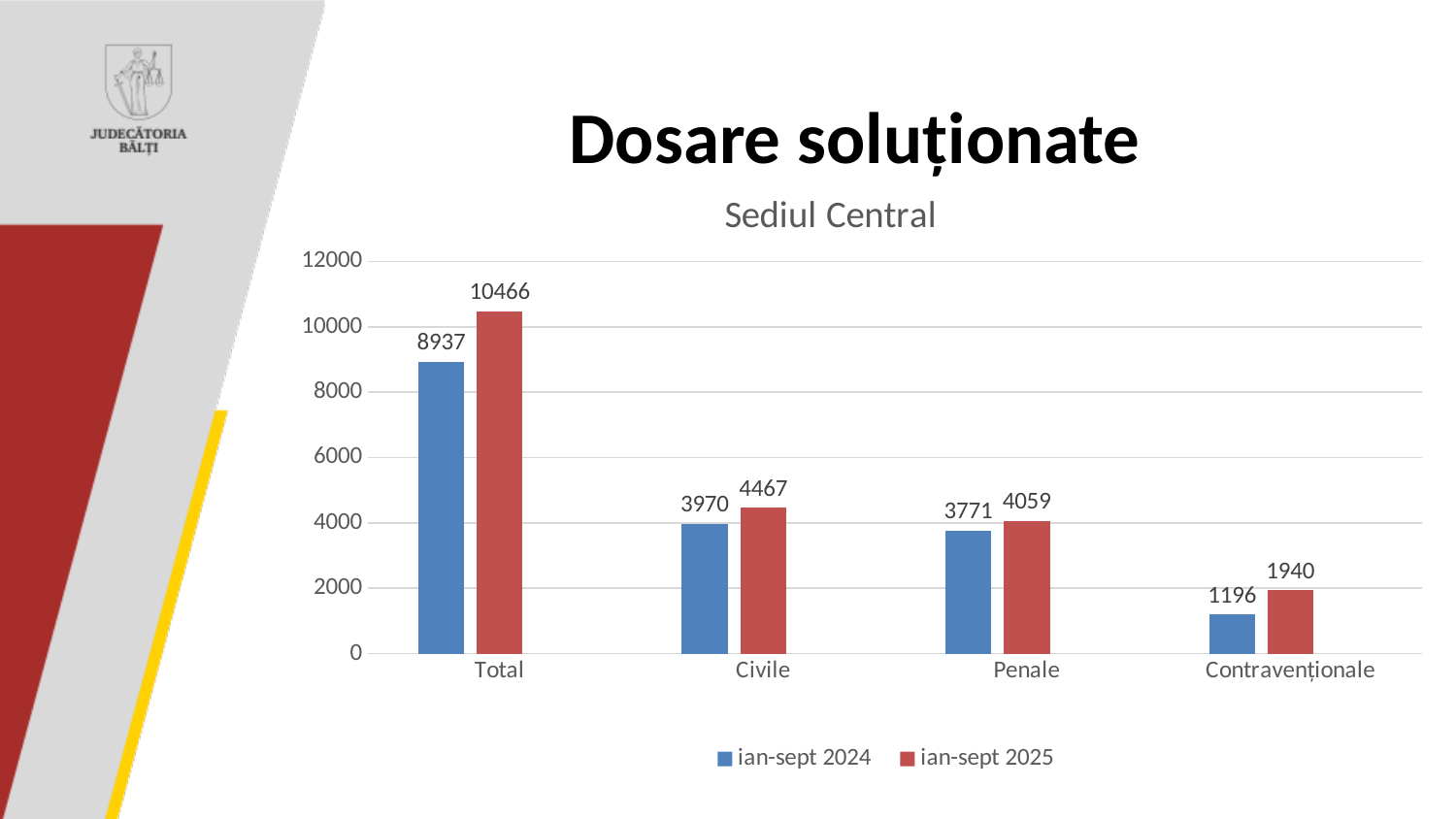
What is the value for Civile in the ian-sept 2024 series? 3970 How many series does the legend list? 2 Which category has the highest value in the ian-sept 2025 series? Total What kind of chart is shown on the slide? bar chart What is the difference between the ian-sept 2025 and ian-sept 2024 values for Penale? 288 What is the difference between the ian-sept 2025 and ian-sept 2024 values for Total? 1529 What is the value for Contravenționale in the ian-sept 2025 series? 1940 What is the value for Total in the ian-sept 2025 series? 10466 Which is larger for Civile: the ian-sept 2024 value or the ian-sept 2025 value? ian-sept 2025 Which category has the lowest value in the ian-sept 2024 series? Contravenționale How many categories are shown on the x axis? 4 What is the value for Penale in the ian-sept 2024 series? 3771